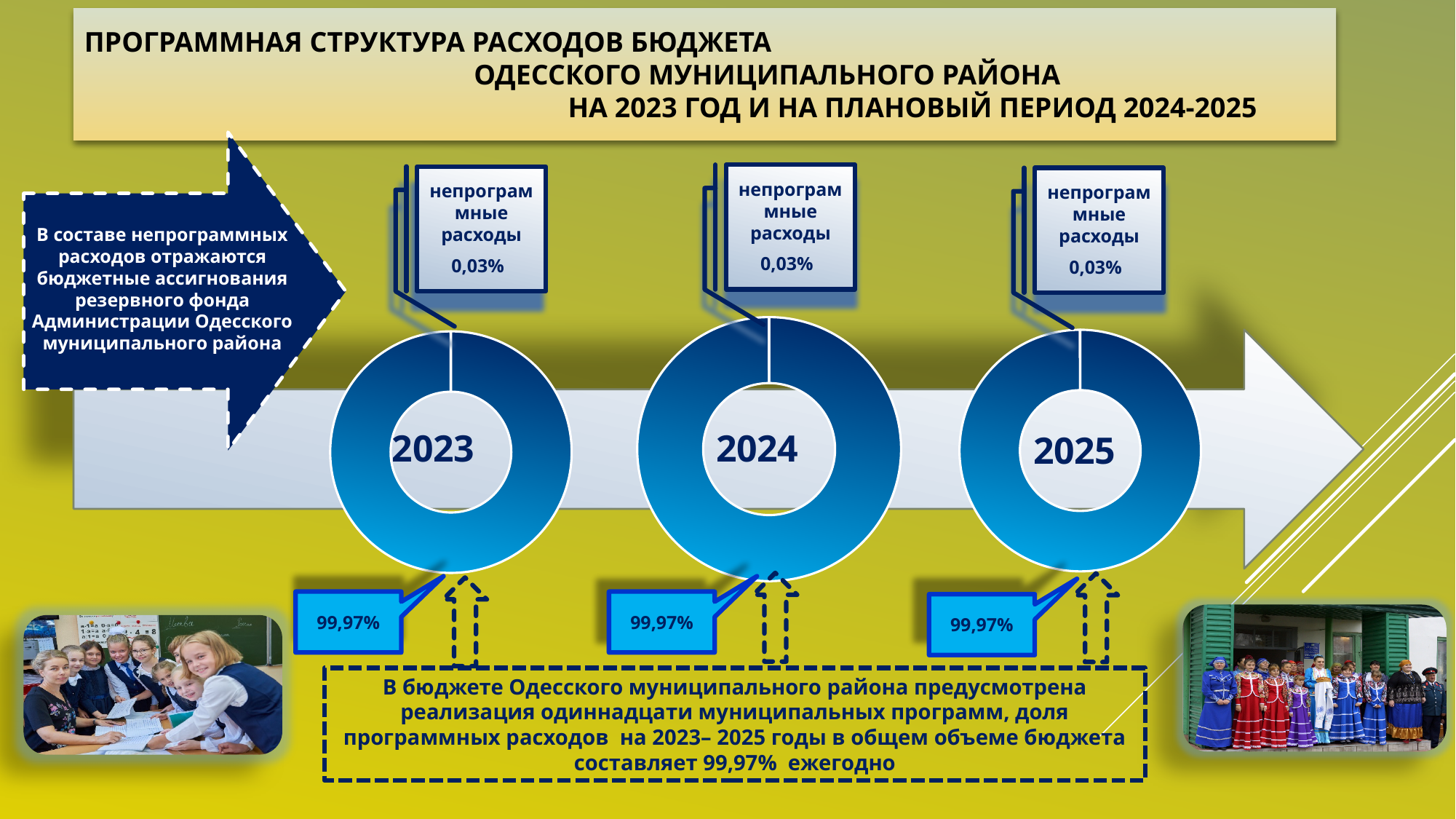
Does the share of непрограммные расходы rise, fall or stay the same from 2023 to 2025? Stays the same What kind of chart is used for each year (2023, 2024, 2025) on the slide? Donut (pie) chart How many donut charts are shown on the slide? 3 In the 2024 donut chart, what share is labelled as непрограммные расходы? 0,03% Which years are labelled in the centres of the three donut charts? 2023, 2024, 2025 How many slices does each donut chart have? 2 In the 2023 donut chart, what is the difference between the программные расходы share and the непрограммные расходы share? 99,94% In the 2023 donut chart, what share is labelled as непрограммные расходы? 0,03% In the 2025 donut chart, what share is labelled as непрограммные расходы? 0,03% In the 2025 donut chart, what share is shown for программные расходы (the large slice)? 99,97% In the 2023 donut chart, what share is shown for программные расходы (the large slice)? 99,97% In the 2024 donut chart, which slice is larger: программные расходы or непрограммные расходы? программные расходы